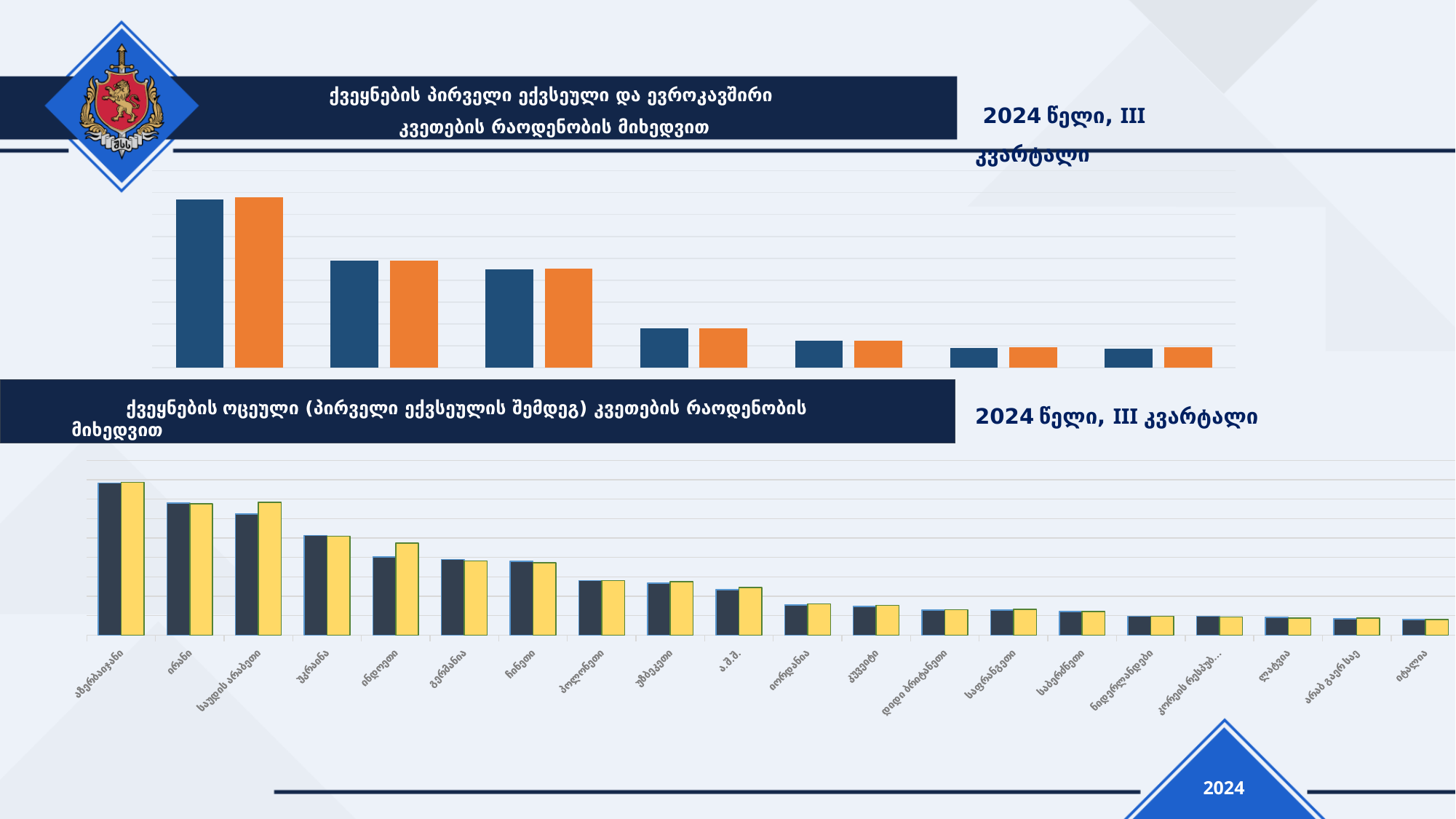
What type of chart is the bottom chart on the slide? bar chart In the bottom chart, which category has the highest bars? აზერბაიჯანი In the bottom chart, how many categories are plotted along the x axis? 20 In the bottom chart, for ინდოეთი, which bar is taller: the dark bar or the yellow bar? the yellow bar In the bottom chart, which category has the lowest bars? იტალია In the top chart, how many groups of bars (categories) are plotted? 7 What type of chart is the top chart on the slide? bar chart In the top chart, in the first (leftmost) group, which bar is taller: the blue bar or the orange bar? the orange bar In the bottom chart, do the values generally rise or fall from left to right along the x axis? fall In the bottom chart, which has the taller dark bar: უკრაინა or ინდოეთი? უკრაინა In the top chart, do the bar heights rise or fall from left to right? fall What two colours are used for the bars in the bottom chart? dark navy and yellow